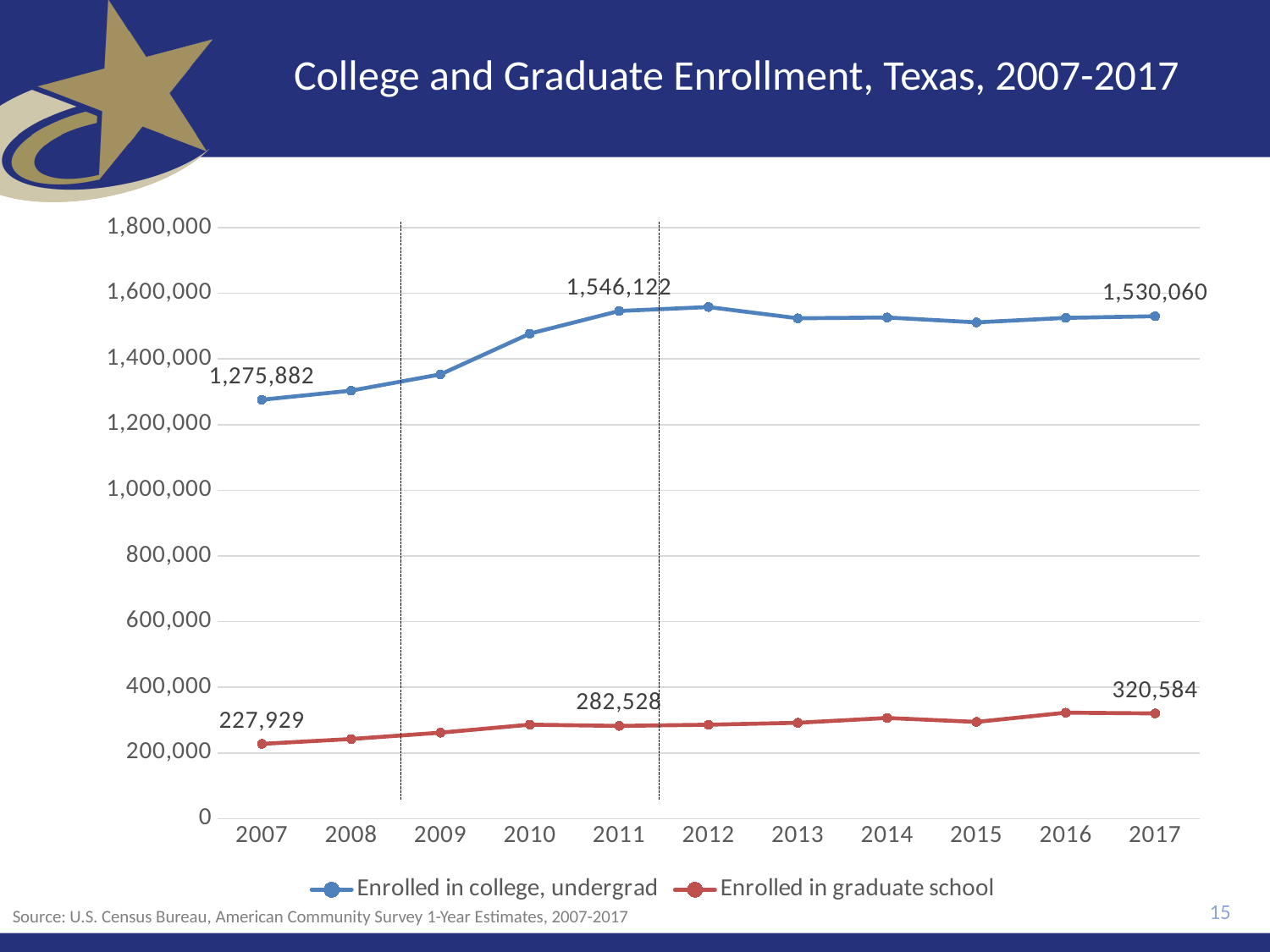
Which year had the lowest undergraduate enrollment? 2007 What was the graduate school enrollment value labeled for 2011? 282,528 What is the difference between undergraduate enrollment in 2011 and in 2017? 16,062 Which year had the lowest graduate school enrollment? 2007 Is the undergraduate enrollment value for 2010 greater or less than 1,400,000? greater How many years are shown on the x axis of the chart? 11 By how much did graduate school enrollment increase from 2007 to 2017? 92,655 What was the number enrolled in college, undergrad in Texas in 2007? 1,275,882 Is the graduate school enrollment value for 2014 greater or less than 400,000? less What was the undergraduate enrollment value labeled for 2011? 1,546,122 What was the number enrolled in graduate school in Texas in 2017? 320,584 What type of chart is used on this slide? Line chart